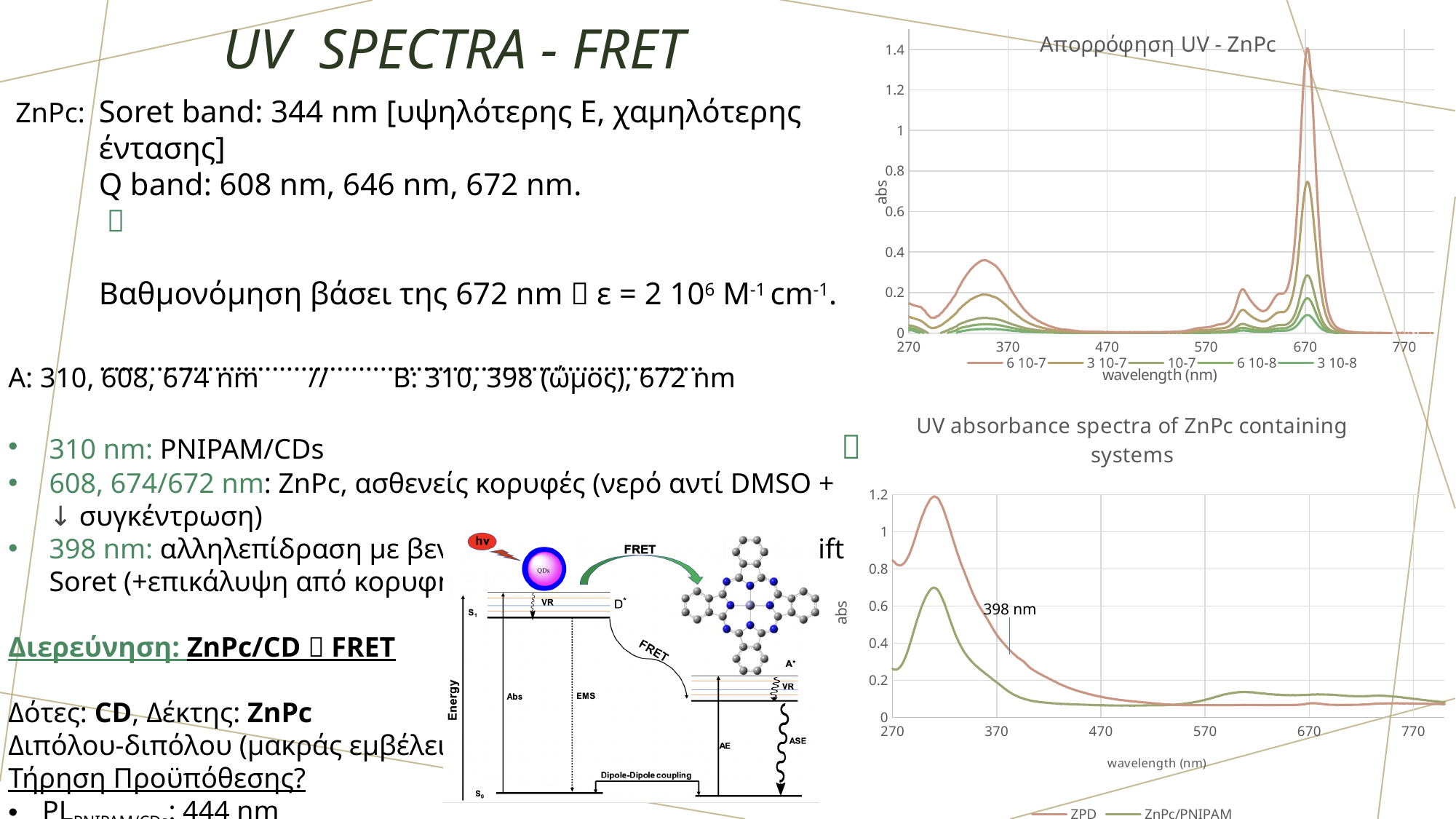
In the chart "UV absorbance spectra of ZnPc containing systems", is the peak absorbance of the ZnPc/PNIPAM series greater or less than 0.8? less How many series does the legend of the chart "Απορρόφηση UV - ZnPc" list? 5 What wavelength is annotated on the chart "UV absorbance spectra of ZnPc containing systems"? 398 nm What is the x-axis label of the chart "Απορρόφηση UV - ZnPc"? wavelength (nm) In the chart "Απορρόφηση UV - ZnPc", is the peak absorbance of the 3 10-7 series near 670 nm greater or less than 1? less In the chart "UV absorbance spectra of ZnPc containing systems", is the peak absorbance of the ZPD series greater or less than 1? greater In the chart "UV absorbance spectra of ZnPc containing systems", which series has the higher peak near 310 nm, ZPD or ZnPc/PNIPAM? ZPD How many series does the legend of the chart "UV absorbance spectra of ZnPc containing systems" list? 2 What kind of chart is the chart titled "Απορρόφηση UV - ZnPc"? line chart What kind of chart is the chart titled "UV absorbance spectra of ZnPc containing systems"? line chart In the chart "Απορρόφηση UV - ZnPc", which series reaches the highest absorbance? 6 10-7